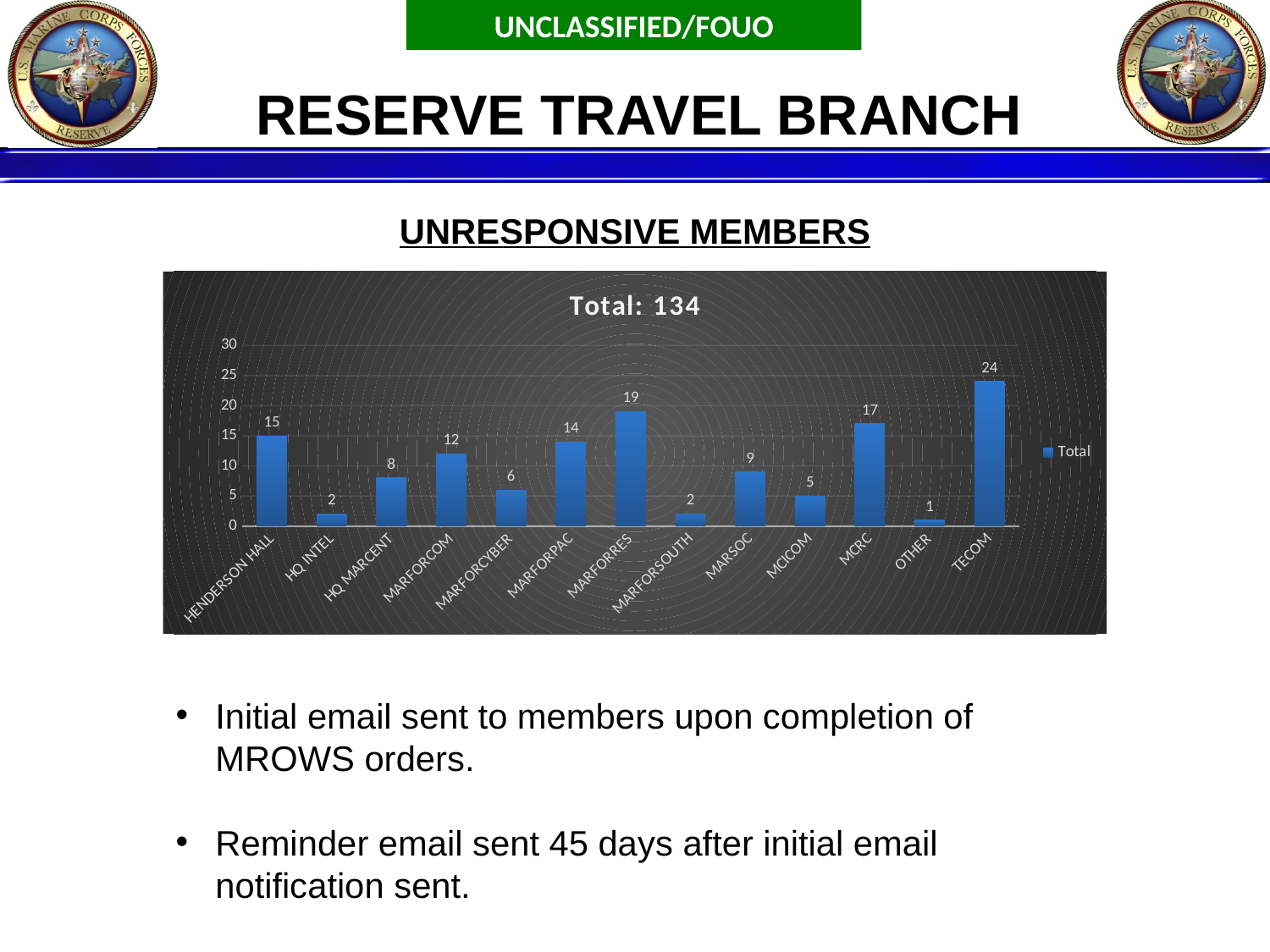
What is the title of the chart? Total: 134 How many categories are shown on the x axis? 13 Which category has the highest value? TECOM What is the value for TECOM? 24 Which category has the lowest value? OTHER Is the value for MARSOC greater or less than 10? less What kind of chart is shown? bar chart Which is larger, the value for MARFORPAC or the value for MARFORCOM? MARFORPAC What is the value for MARFORRES? 19 What is the difference between the values for TECOM and MCRC? 7 What is the value for HQ MARCENT? 8 How many series does the legend list? 1